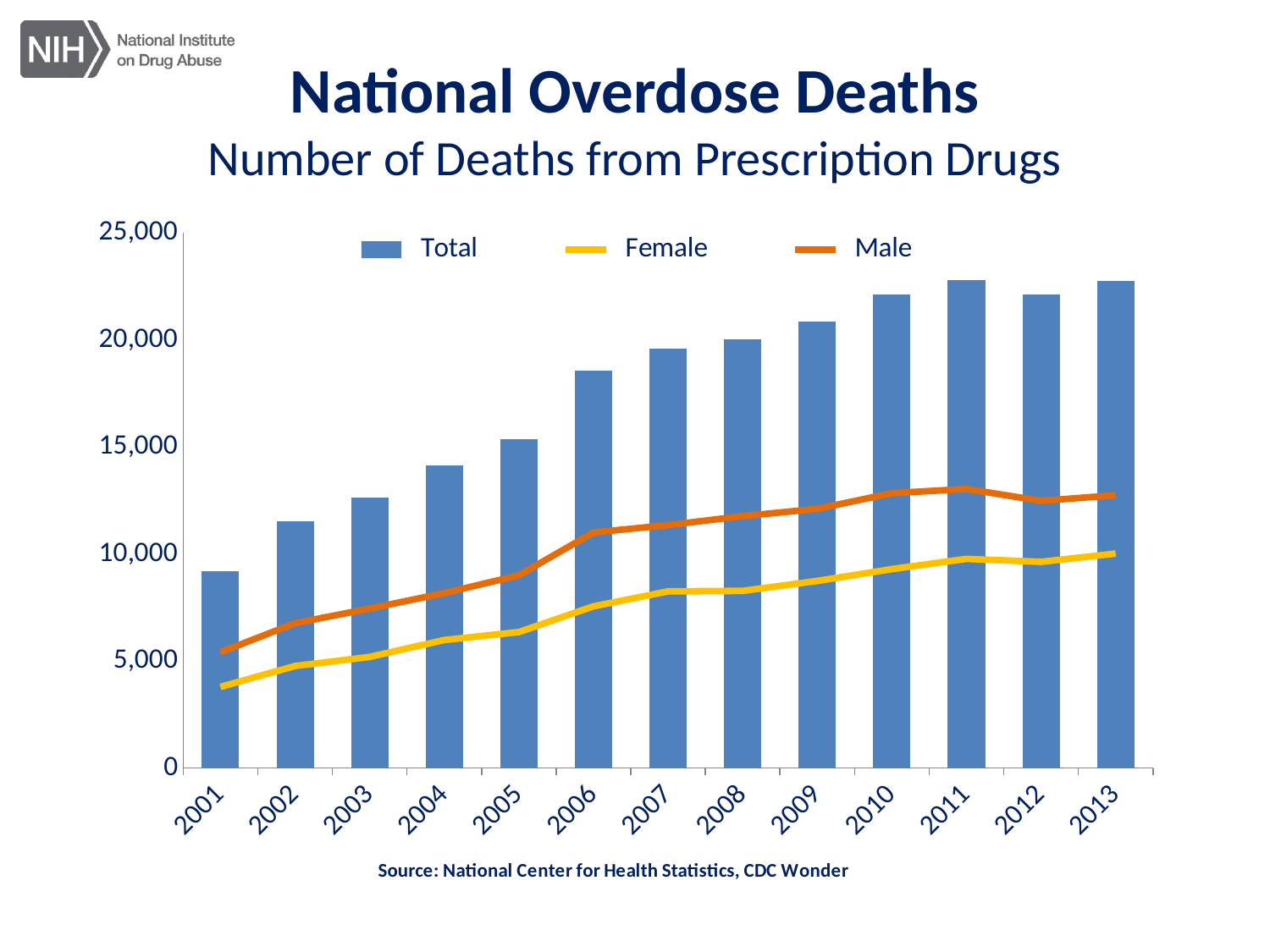
Is the Female value for 2001 greater or less than 5,000? less Do the Total values generally rise or fall from 2001 to 2013? rise How many series does the legend list? 3 How many years are shown along the x axis? 13 In 2013, which is larger, the Male value or the Female value? Male Is the Male value for 2005 greater or less than 10,000? less Which year has the lowest Total number of deaths? 2001 What colour is the Female line in the chart? Yellow Is the Total value for 2006 greater or less than 15,000? greater What kind of chart is shown on the slide? A bar chart with two line series